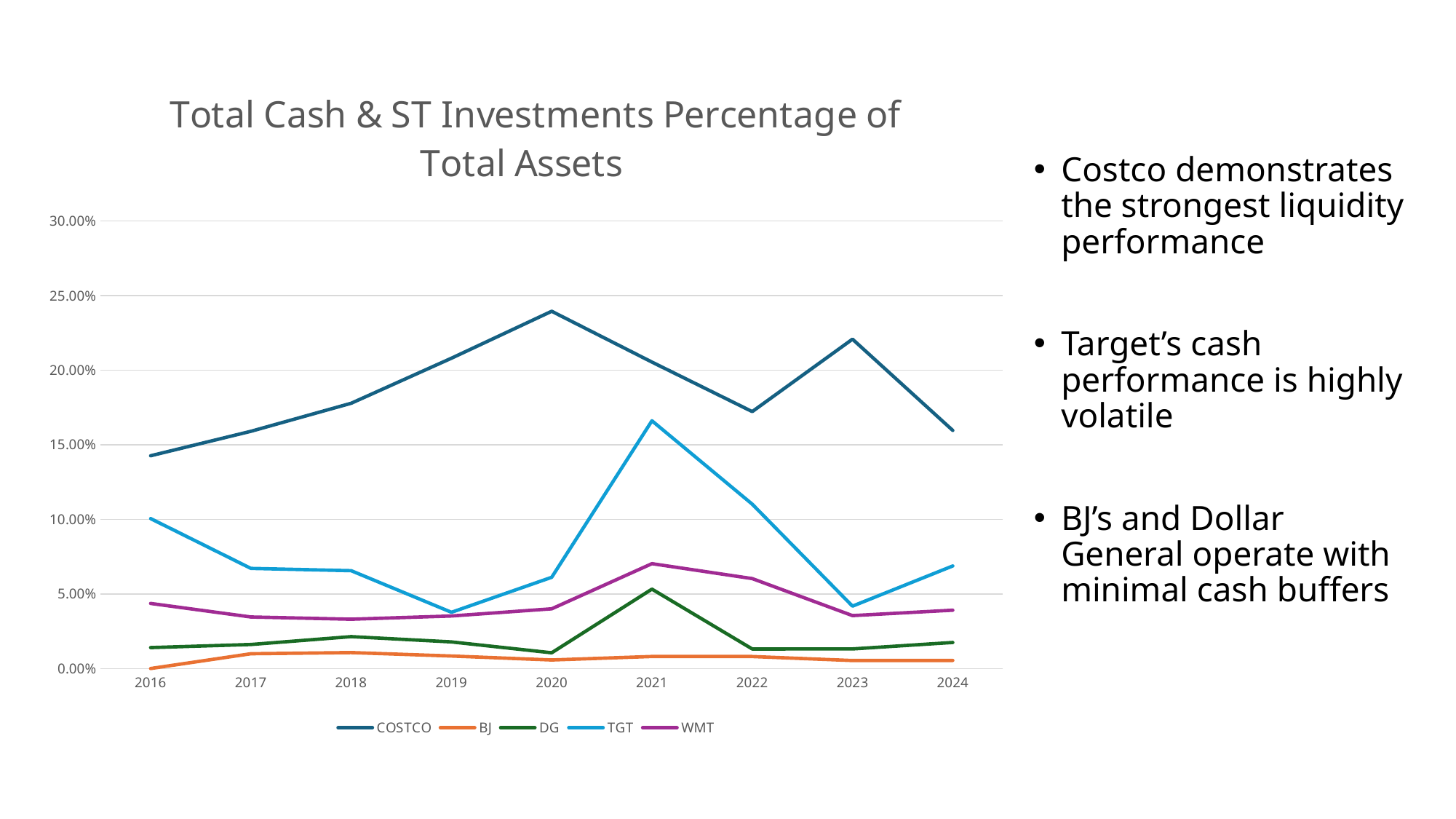
Which series has the lowest value in 2016? BJ In which year does the TGT line reach its highest point? 2021 Does the COSTCO line rise or fall from 2016 to 2020? rise How many series does the legend list? 5 Which is larger in 2016, the value for TGT or the value for WMT? TGT How many years are shown on the x axis? 9 Is the value for WMT in 2021 greater or less than 5.00%? greater Is the value for TGT in 2021 greater or less than 15.00%? greater Which series has the highest value in 2021? COSTCO Is the value for COSTCO in 2020 greater or less than 20.00%? greater In which year does the COSTCO line reach its highest point? 2020 What kind of chart is shown on the slide? line chart